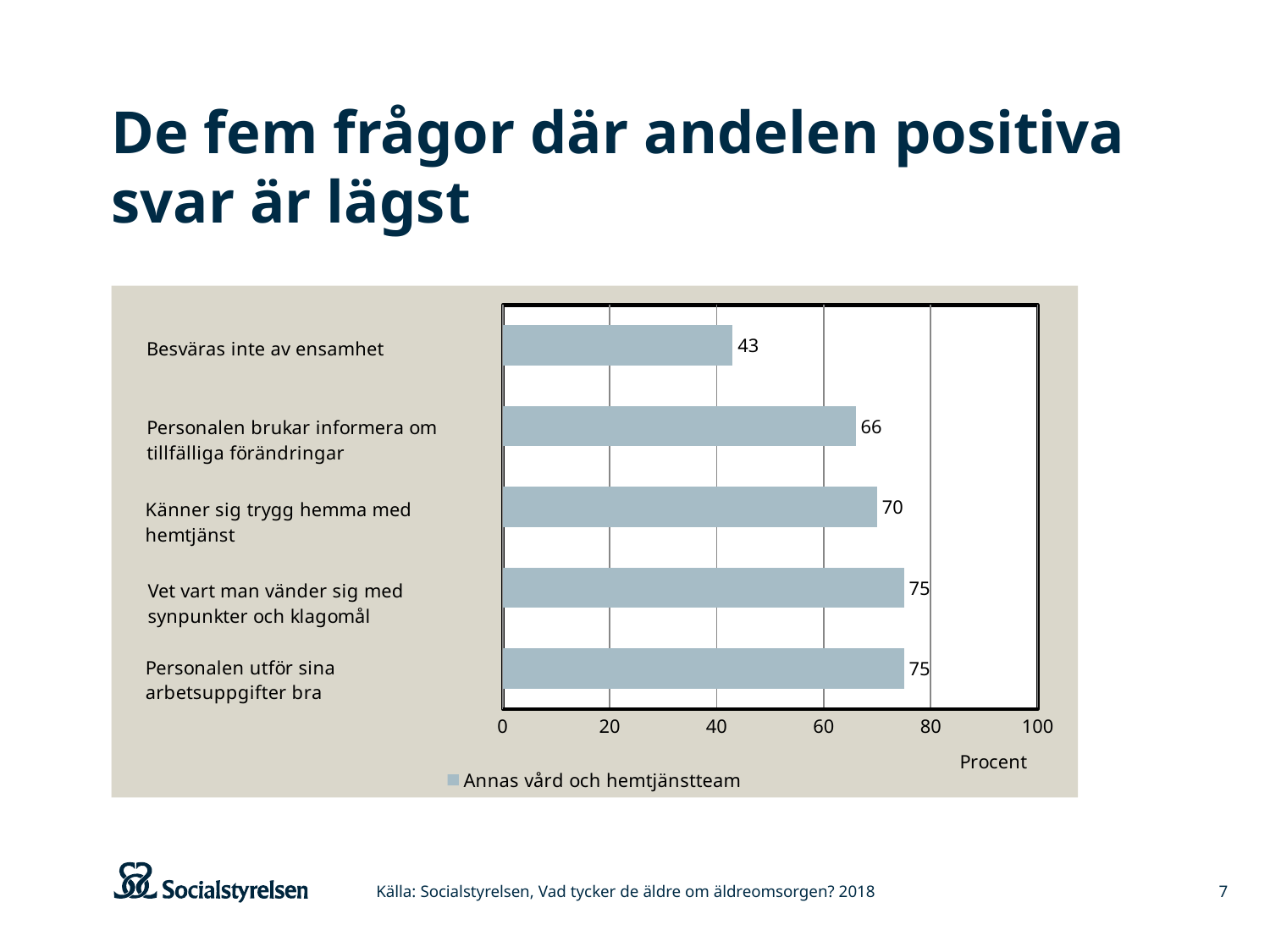
What is the value for "Vet vart man vänder sig med synpunkter och klagomål"? 75 What is the difference between the values for "Känner sig trygg hemma med hemtjänst" and "Besväras inte av ensamhet"? 27 What is the value for "Besväras inte av ensamhet"? 43 What is the value for "Personalen brukar informera om tillfälliga förändringar"? 66 What is the value for "Känner sig trygg hemma med hemtjänst"? 70 How many categories are shown in the chart? 5 What series does the legend list? Annas vård och hemtjänstteam What is the difference between the values for "Personalen utför sina arbetsuppgifter bra" and "Personalen brukar informera om tillfälliga förändringar"? 9 Which category has the lowest value? Besväras inte av ensamhet What kind of chart is shown on the slide? bar chart Which is larger, the value for "Känner sig trygg hemma med hemtjänst" or the value for "Personalen brukar informera om tillfälliga förändringar"? Känner sig trygg hemma med hemtjänst Is the value for "Besväras inte av ensamhet" greater or less than 60? less